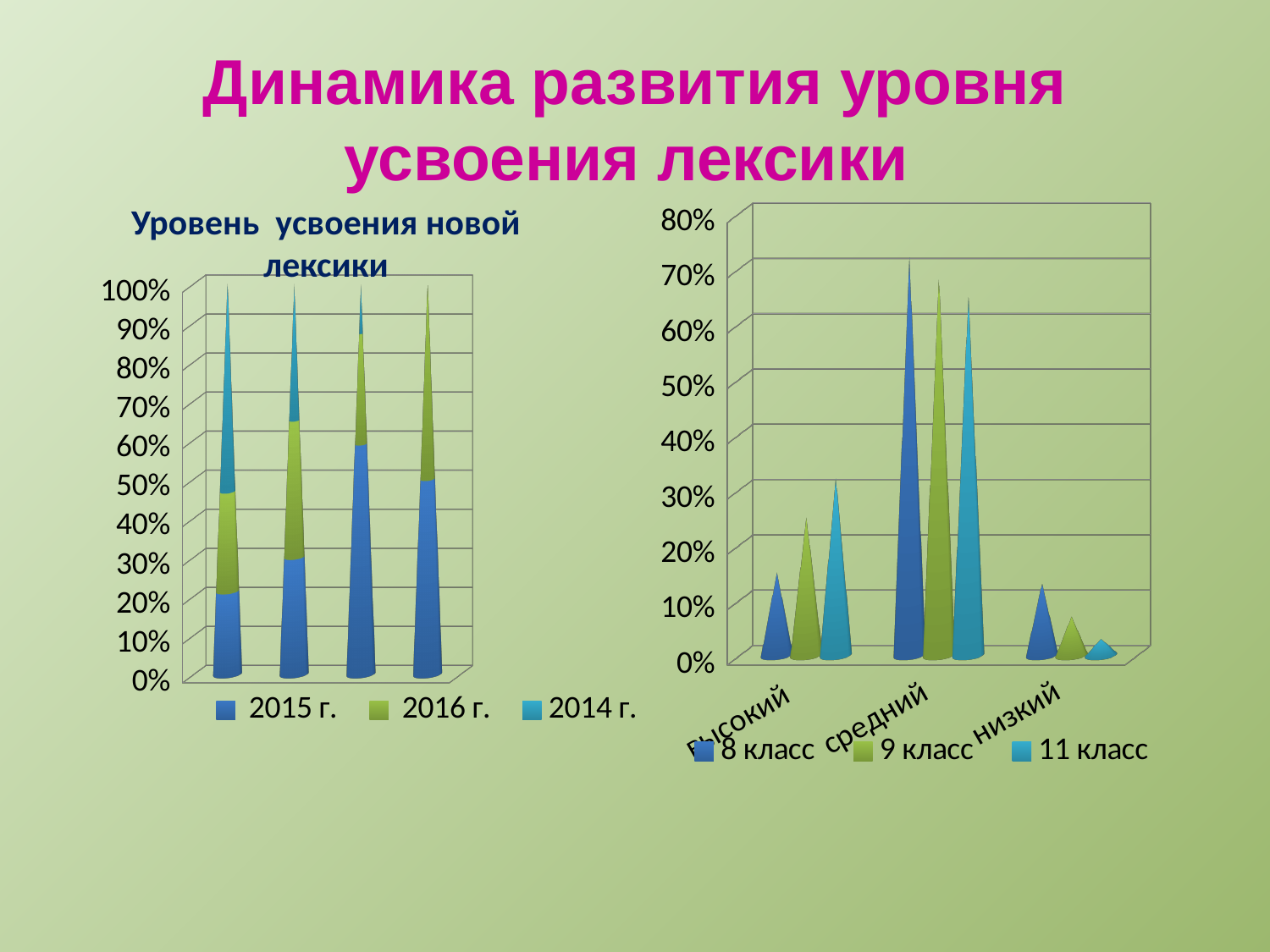
On the right chart, which series has the lowest value for the category низкий? 11 класс On the right chart, is the value for 11 класс in the category высокий greater or less than 20%? greater On the right chart, what are the three categories on the x axis? высокий, средний, низкий On the right chart, is the value for 9 класс in the category средний greater or less than 60%? greater What is the title of the chart on the left? Уровень усвоения новой лексики On the right chart, how many series does the legend list? 3 What kind of chart is the chart on the left? Stacked bar chart On the right chart, is the value for 9 класс in the category низкий greater or less than 10%? less On the right chart, which series has the highest value for the category высокий? 11 класс On the right chart, which is larger for the category низкий: the value for 8 класс or the value for 9 класс? 8 класс On the left chart, how many series does the legend list? 3